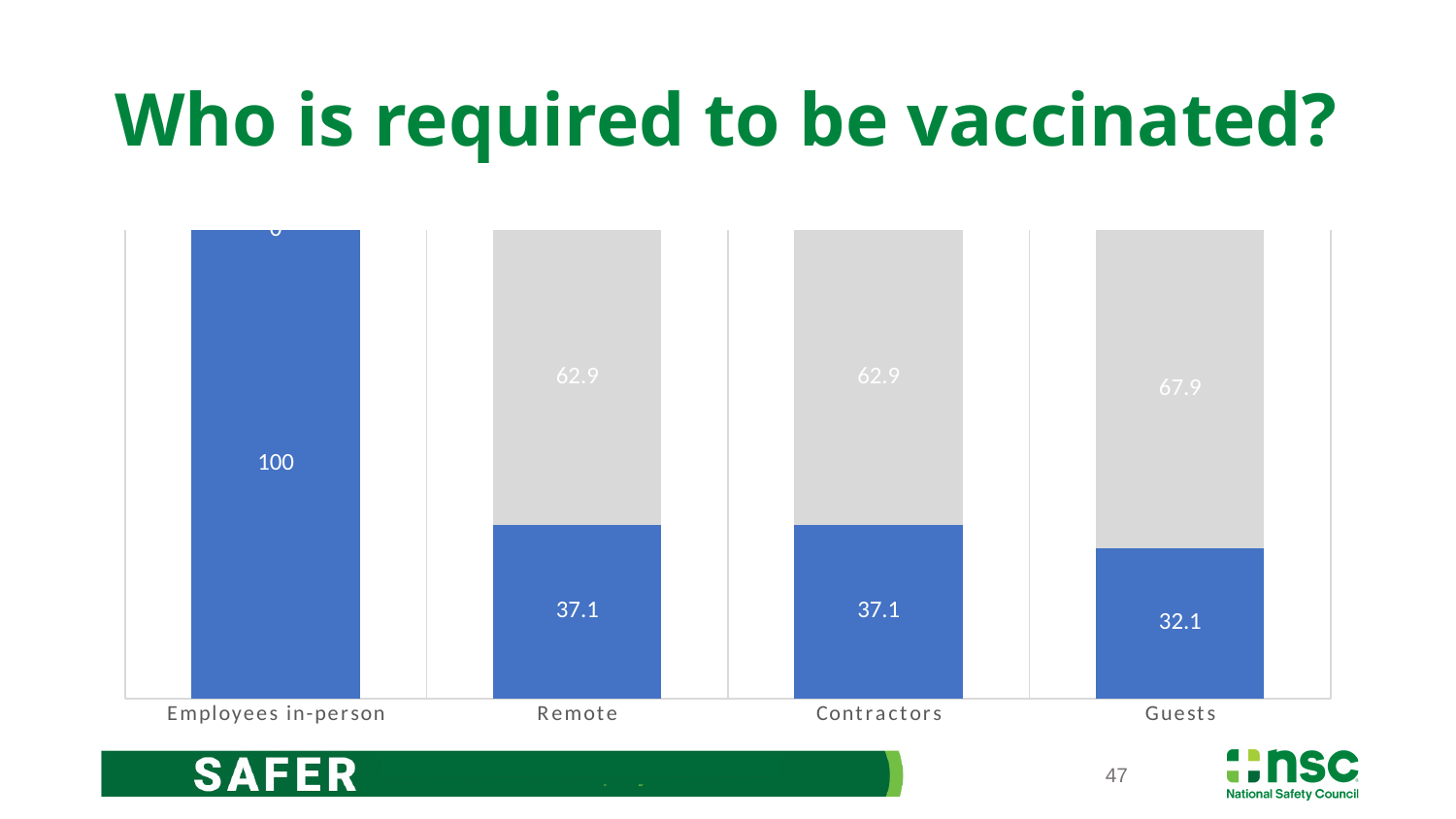
What is the value of the blue segment for Remote? 37.1 What is the difference between the grey segment for Guests and the grey segment for Remote? 5 What is the title of the slide? Who is required to be vaccinated? What is the value of the grey segment for Guests? 67.9 Is the blue segment for Remote larger or smaller than the blue segment for Guests? larger What is the value of the blue segment for Employees in-person? 100 What is the total of the stacked bar for Contractors? 100 Which category has the smallest blue segment? Guests How many categories are shown on the x axis? 4 What is the value of the grey segment for Contractors? 62.9 Which category has the largest blue segment? Employees in-person What is the value of the blue segment for Guests? 32.1